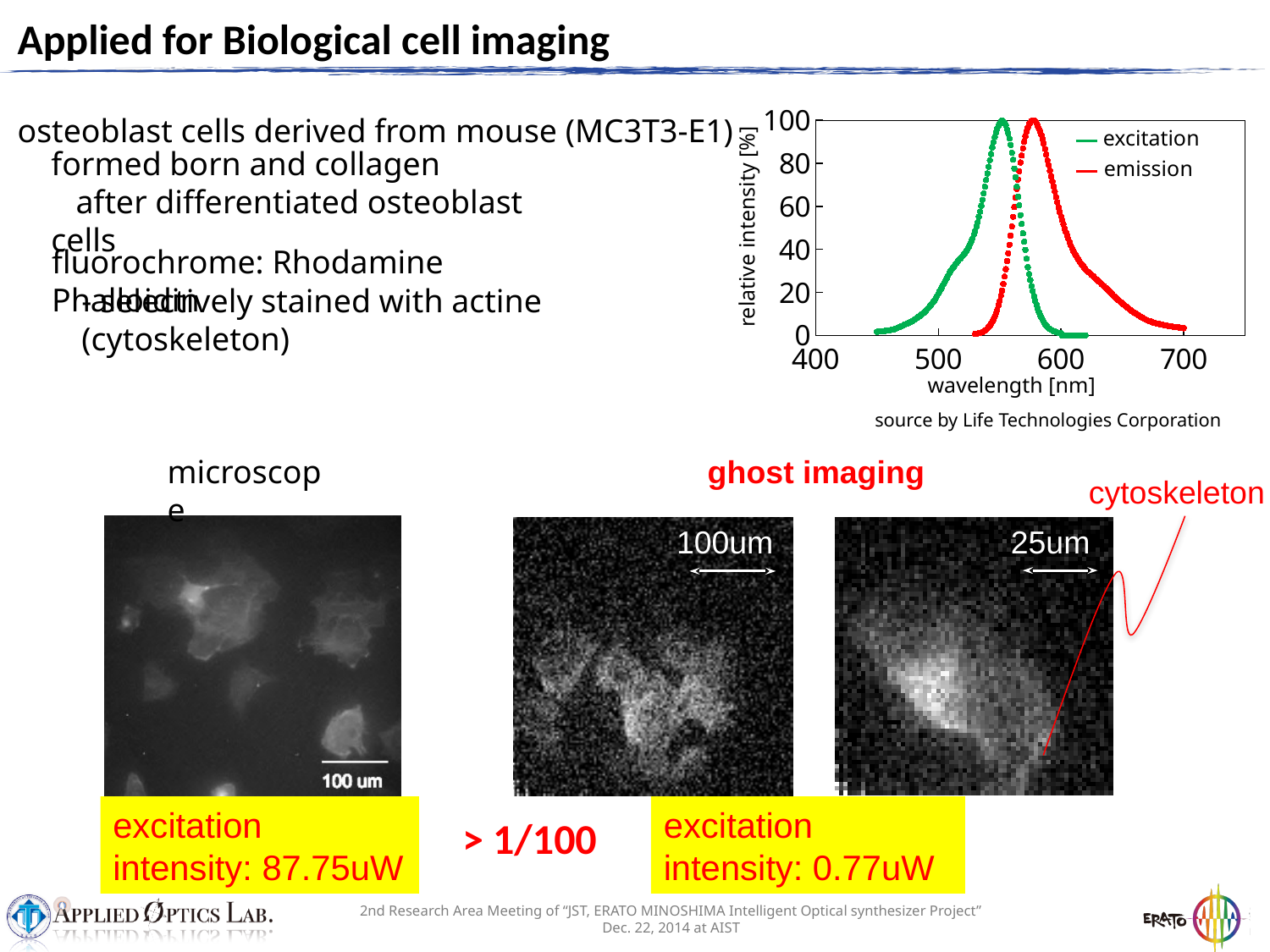
Is the emission value at 650 nm greater or less than 20? less Which series in the spectrum chart reaches its peak at a longer wavelength, excitation or emission? emission How does the excitation curve behave as wavelength increases from 450 nm to 650 nm? rises to a peak then falls How many series does the legend of the spectrum chart list? 2 What are the two series named in the legend of the spectrum chart? excitation and emission Is the excitation value at 450 nm greater or less than 20? less What is the range of the x axis of the spectrum chart? 400 to 700 What is the maximum value shown on the y axis of the spectrum chart? 100 Is the excitation value at 600 nm greater or less than 20? less What is the label of the x axis of the spectrum chart? wavelength [nm] What colour is used for the emission series in the spectrum chart? red What is the label of the y axis of the spectrum chart? relative intensity [%]